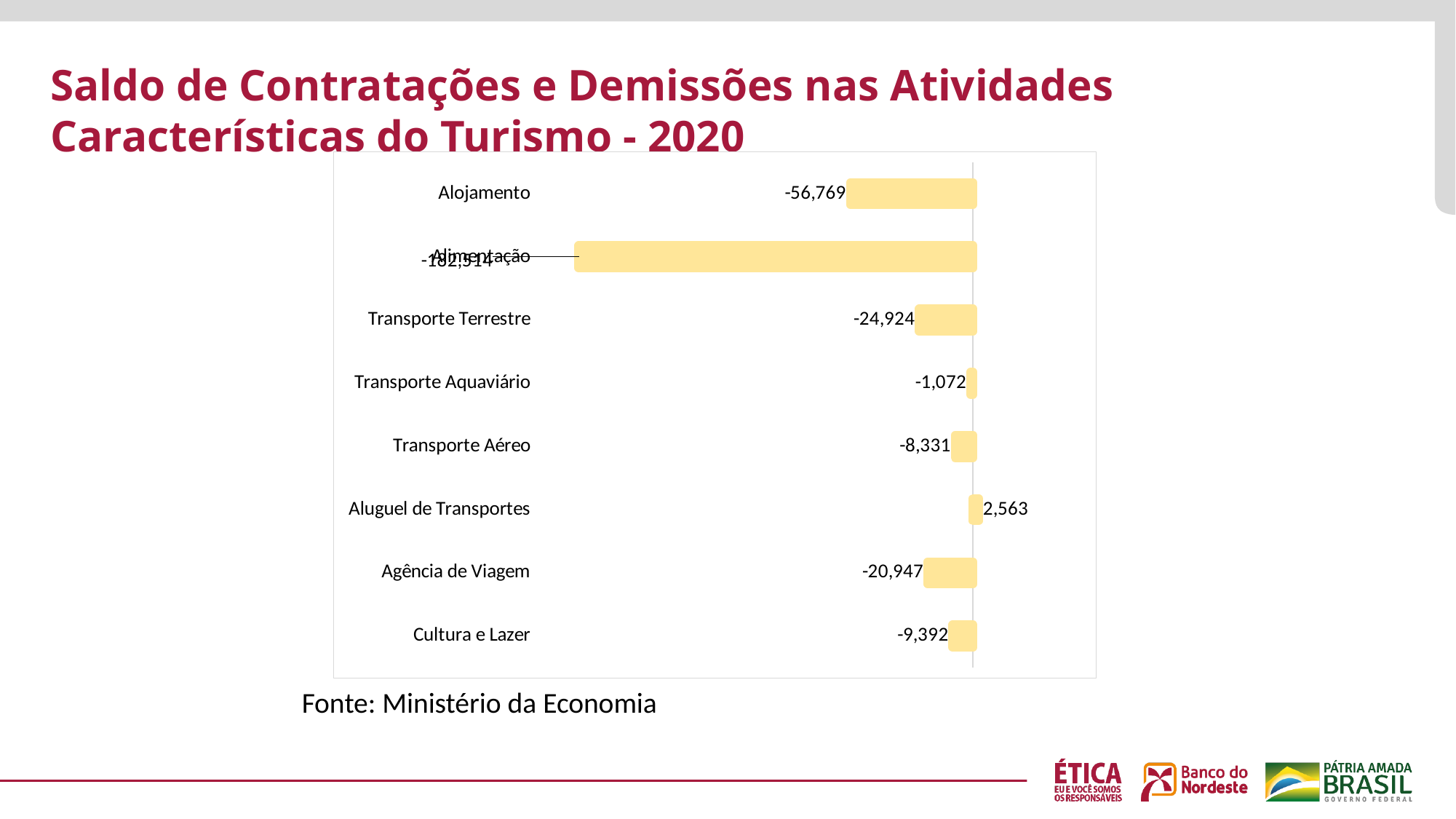
What is the value for Agência de Viagem? -20,947 What is the value for Transporte Terrestre? -24,924 Which category has the highest value? Aluguel de Transportes Which category has the lowest (most negative) value? Alimentação What is the difference between the values for Alojamento and Transporte Terrestre? 31,845 How many categories are shown in the chart? 8 Which has the larger (less negative) value, Transporte Aéreo or Transporte Aquaviário? Transporte Aquaviário What is the value for Alojamento? -56,769 What kind of chart is shown on the slide? Bar chart What is the value for Cultura e Lazer? -9,392 What is the difference between the values for Agência de Viagem and Cultura e Lazer? 11,555 What is the value for Aluguel de Transportes? 2,563